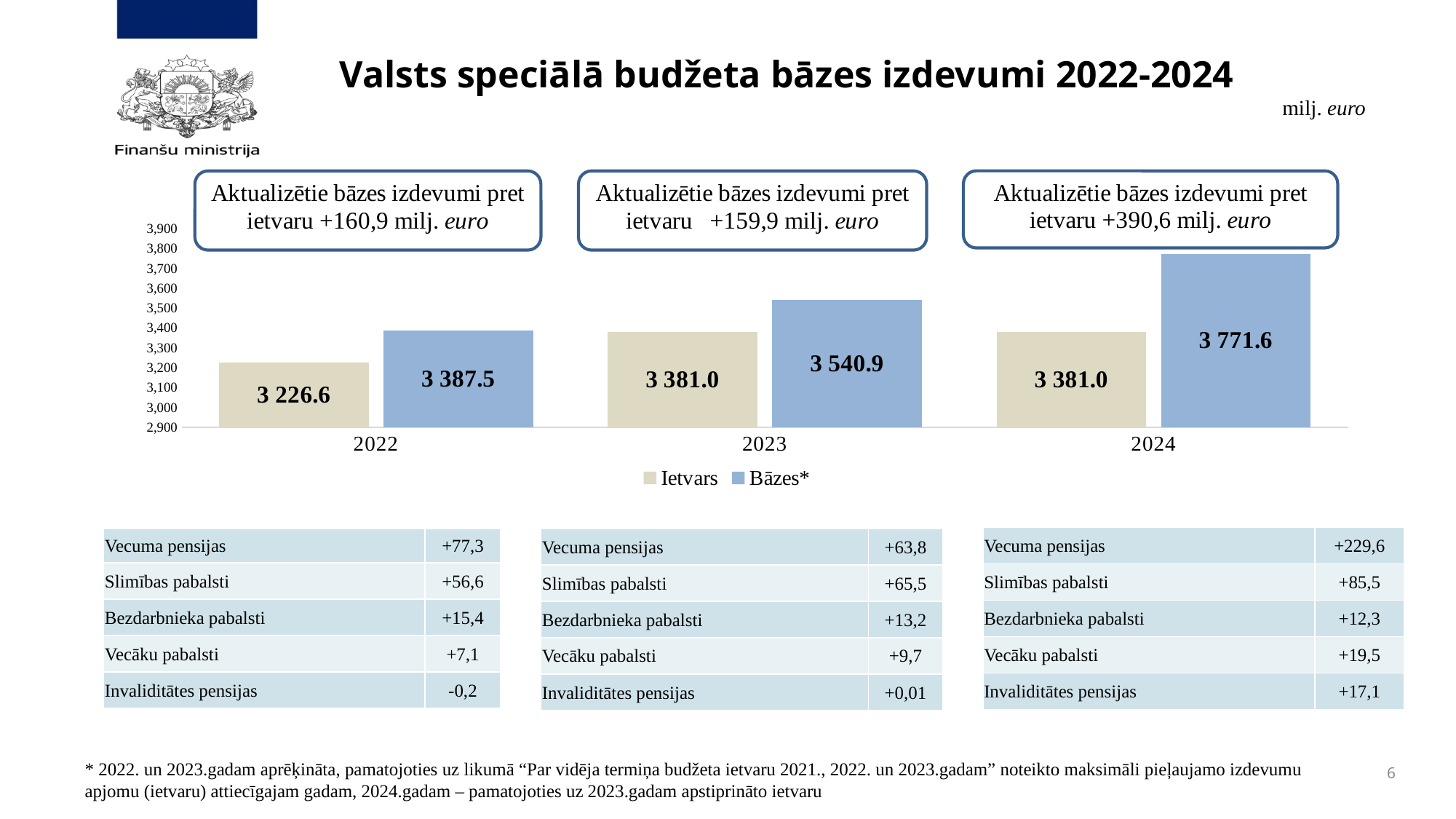
What is the value of Bāzes* for 2023? 3 540.9 What is the difference between Bāzes* and Ietvars in 2022? 160.9 How many series does the legend list? 2 Which year has the lowest Ietvars value? 2022 What kind of chart is shown on the slide? Bar chart What is the difference between Bāzes* and Ietvars in 2024? 390.6 What is the value of Ietvars for 2023? 3 381.0 Which is larger in 2023, Ietvars or Bāzes*? Bāzes* Do the Bāzes* values rise or fall from 2022 to 2024? Rise Which year has the highest Bāzes* value? 2024 What is the value of Ietvars for 2022? 3 226.6 What is the value of Bāzes* for 2024? 3 771.6